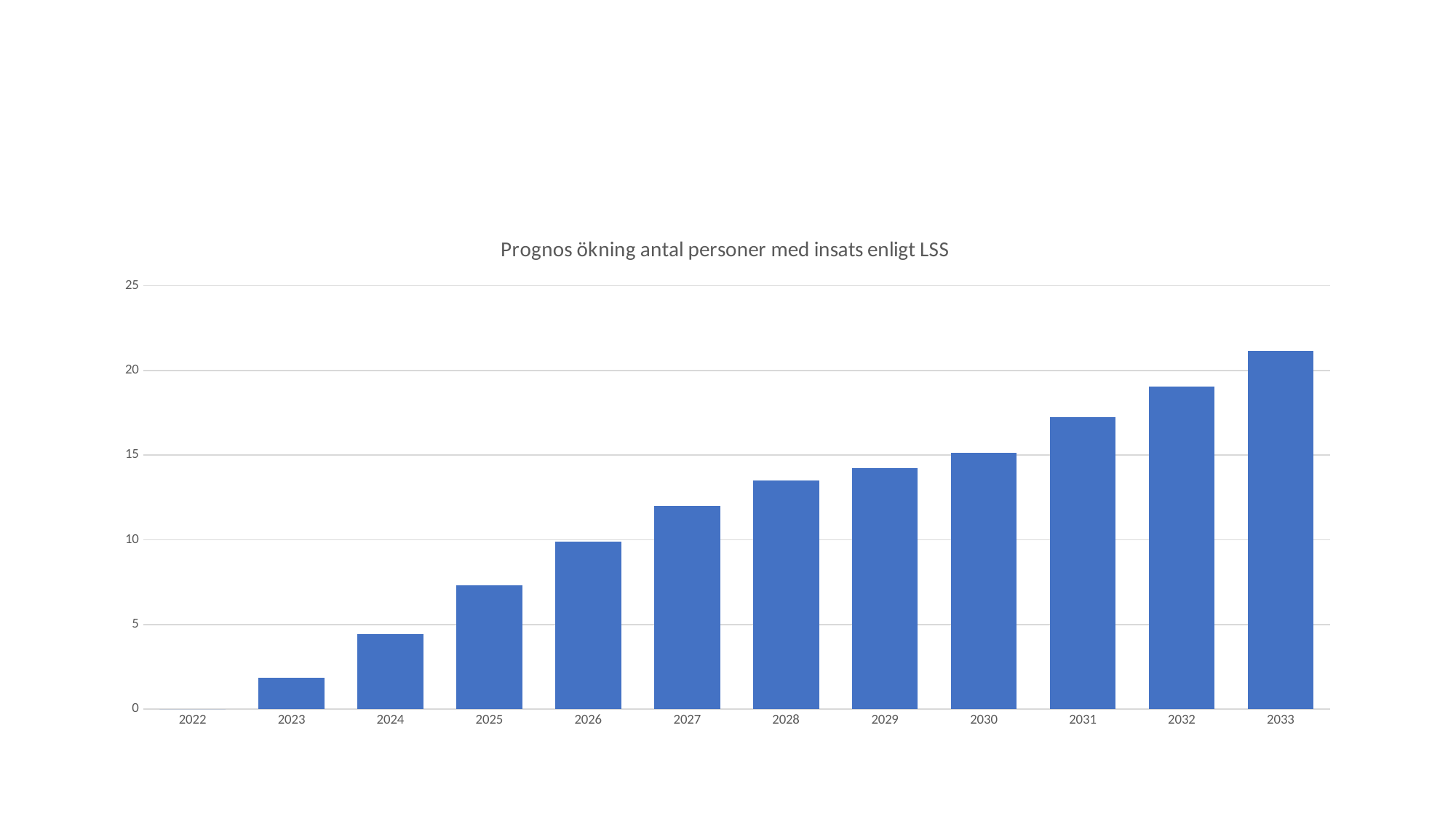
Is the value for 2029 greater or less than 15? less Which year has the highest value in the chart? 2033 Is the value for 2027 greater or less than 10? greater What is the title of the chart? Prognos ökning antal personer med insats enligt LSS Do the values rise or fall from 2022 to 2033? rise Is the value for 2032 greater or less than 20? less What kind of chart is shown on the slide? bar chart Which is larger, the value for 2031 or the value for 2028? 2031 Which year has the lowest value in the chart? 2022 How many years are shown on the x axis of the chart? 12